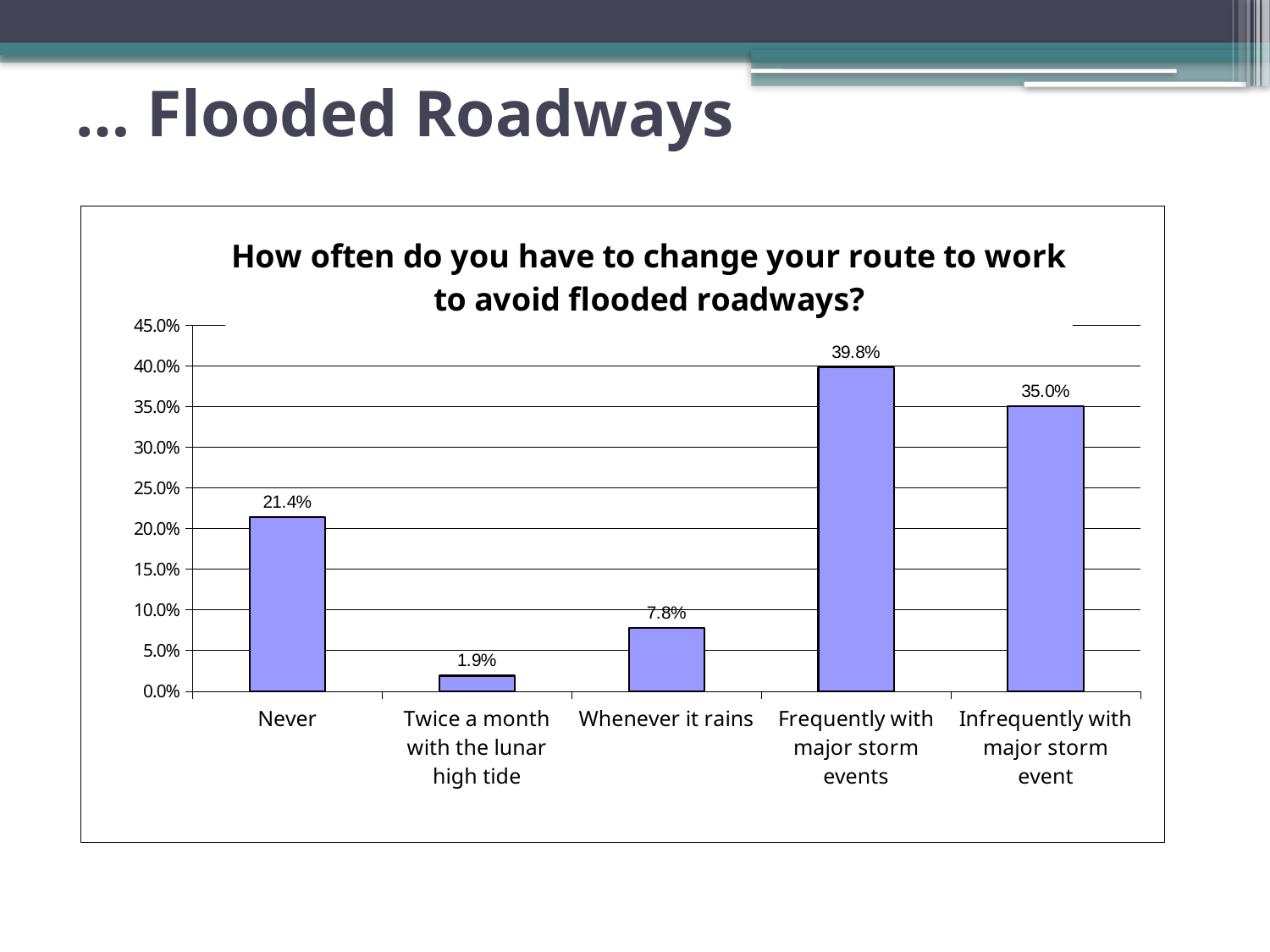
Is the value for "Never" greater or less than 20.0%? greater What is the value for "Twice a month with the lunar high tide"? 1.9% Which is larger: the value for "Never" or the value for "Whenever it rains"? Never What kind of chart is shown on the slide? Bar chart What is the value for "Infrequently with major storm event"? 35.0% How many categories are shown on the x axis? 5 What is the title of the chart? How often do you have to change your route to work to avoid flooded roadways? Which category has the lowest value? Twice a month with the lunar high tide What is the difference between "Frequently with major storm events" and "Infrequently with major storm event"? 4.8% What is the value for "Whenever it rains"? 7.8% Which category has the highest value? Frequently with major storm events What percentage of respondents answered "Never"? 21.4%